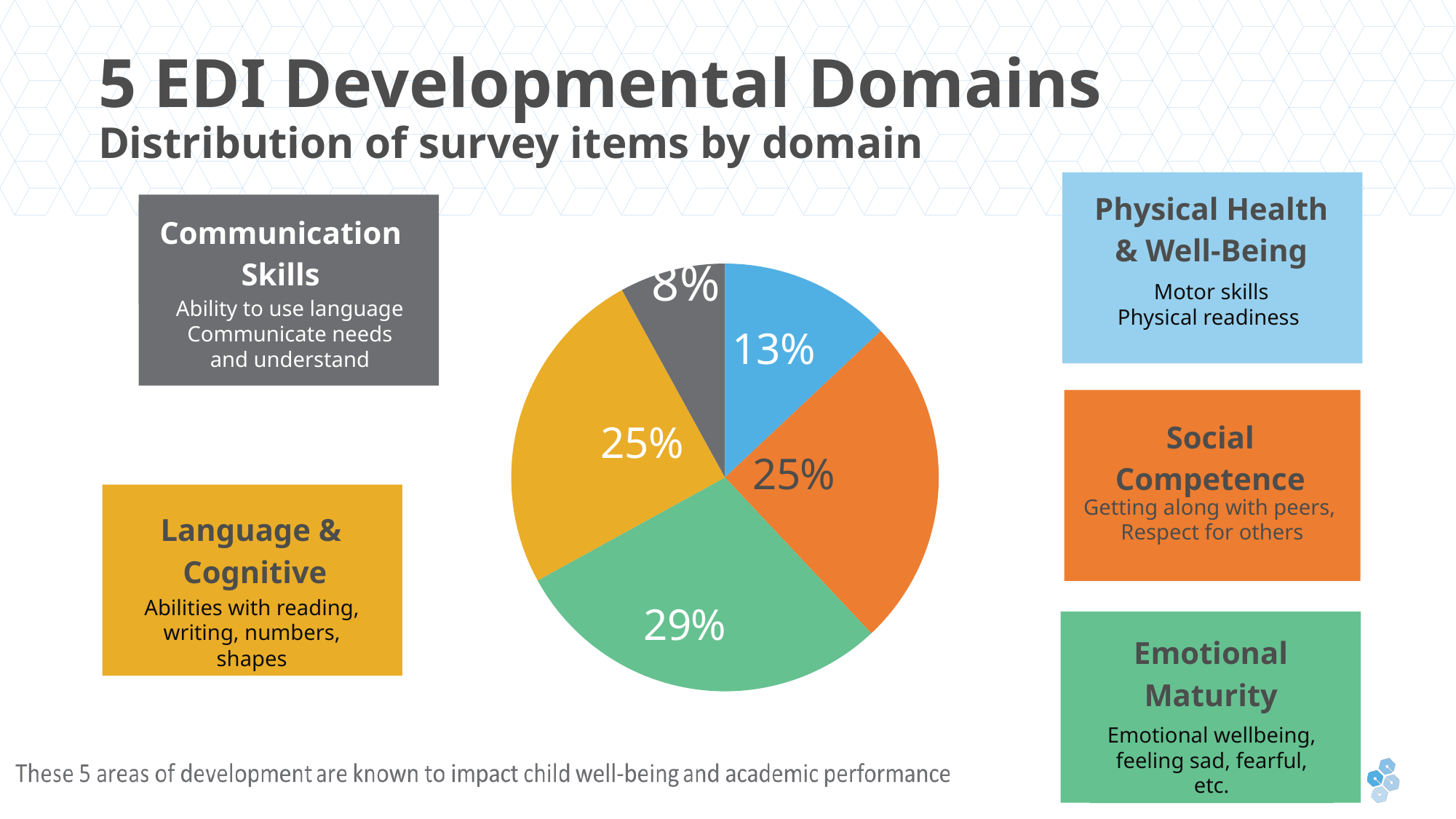
Which slice is larger, the blue (Physical Health & Well-Being) slice or the grey (Communication Skills) slice? Physical Health & Well-Being What share of survey items does the orange slice (Social Competence) represent? 25% What share of survey items does the grey slice (Communication Skills) represent? 8% What kind of chart is shown on the slide? pie chart What share of survey items does the blue slice (Physical Health & Well-Being) represent? 13% What is the subtitle of the chart on the slide? Distribution of survey items by domain What is the difference in percentage points between the Emotional Maturity slice and the Physical Health & Well-Being slice? 16 Which domain has the smallest share of survey items in the pie chart? Communication Skills Which two domains each account for 25% of the survey items? Social Competence and Language & Cognitive What share of survey items does the green slice (Emotional Maturity) represent? 29% Which domain has the largest share of survey items in the pie chart? Emotional Maturity How many slices does the pie chart have? 5